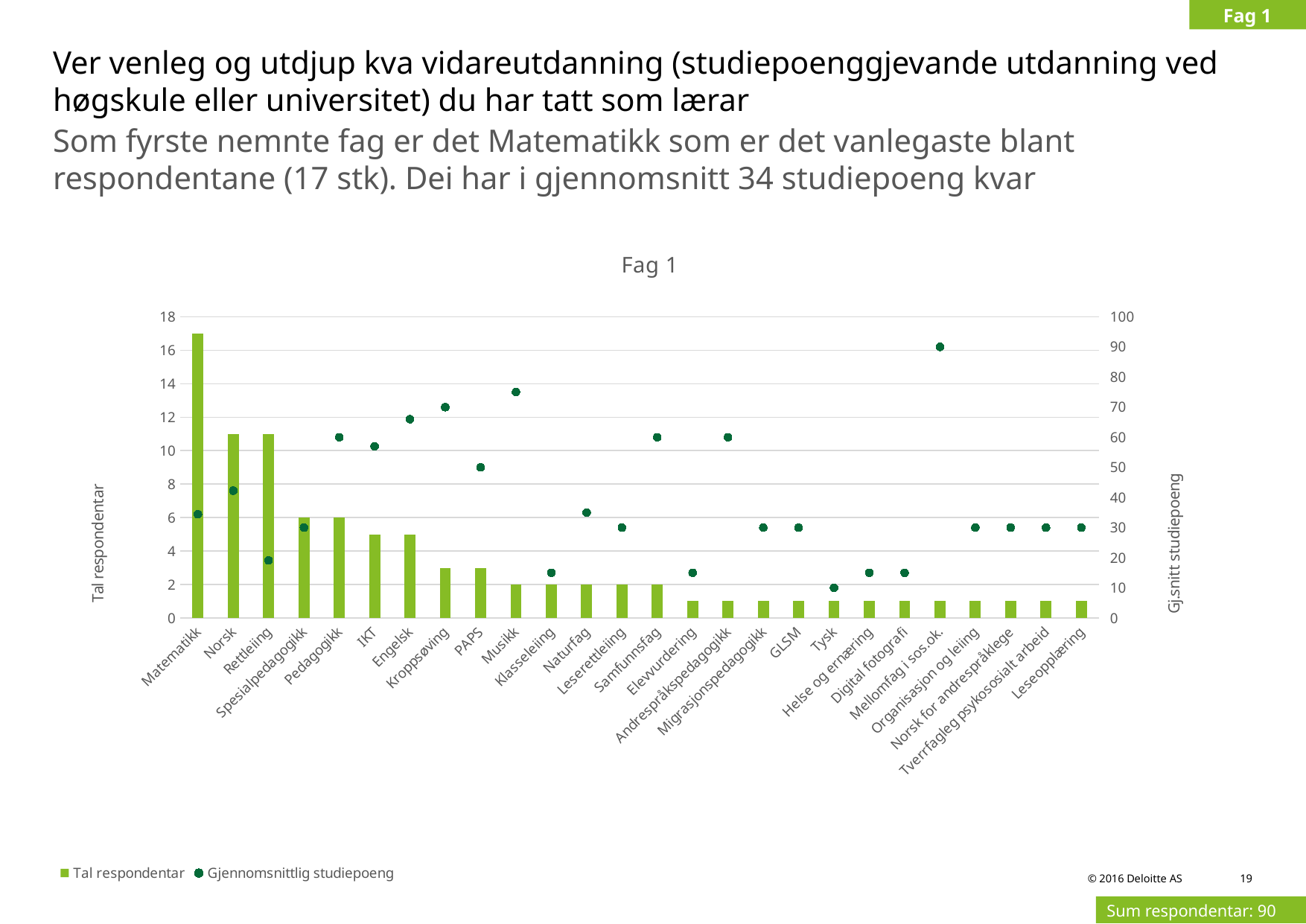
How many series does the legend list? 2 What is the average study credits (Gjennomsnittlig studiepoeng) value for Mellomfag i sos.ok.? 90 What kind of chart is shown on the slide? A bar chart combined with a dot (point) series How many respondents (Tal respondentar) are shown for Musikk? 2 Which category has the highest number of respondents (Tal respondentar)? Matematikk What is the average study credits (Gjennomsnittlig studiepoeng) value for Kroppsøving? 70 Which has more respondents, Norsk or Spesialpedagogikk? Norsk How many respondents (Tal respondentar) are shown for Pedagogikk? 6 Which category has the highest average study credits (Gjennomsnittlig studiepoeng)? Mellomfag i sos.ok. Is the number of respondents for Matematikk greater or less than 16? greater What is the average study credits (Gjennomsnittlig studiepoeng) value for Tysk? 10 How many categories are shown on the x axis? 26